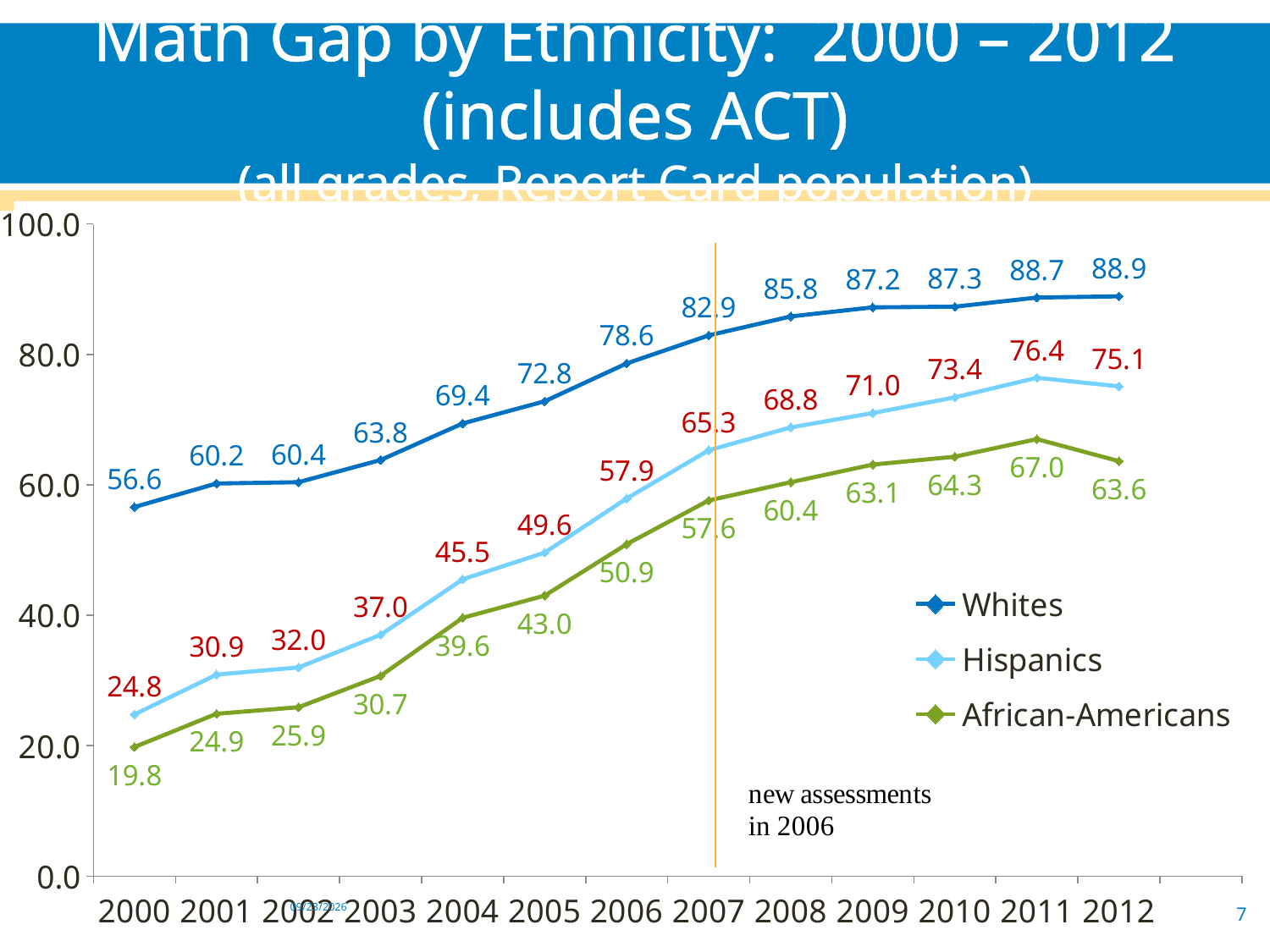
What is the value for Whites in 2012? 88.9 Does the value for Whites generally rise or fall from 2000 to 2012? Rise What is the value for African-Americans in 2000? 19.8 What is the value for Hispanics in 2007? 65.3 According to the annotation on the chart, in which year were new assessments introduced? 2006 In which year is the value for African-Americans lowest? 2000 How many years are plotted along the x axis? 13 What type of chart is shown on the slide? Line chart How many series does the legend list? 3 In which year is the value for Hispanics highest? 2011 Which is larger in 2005, the value for Hispanics or the value for African-Americans? Hispanics What is the difference between the Whites value and the African-Americans value in 2012? 25.3